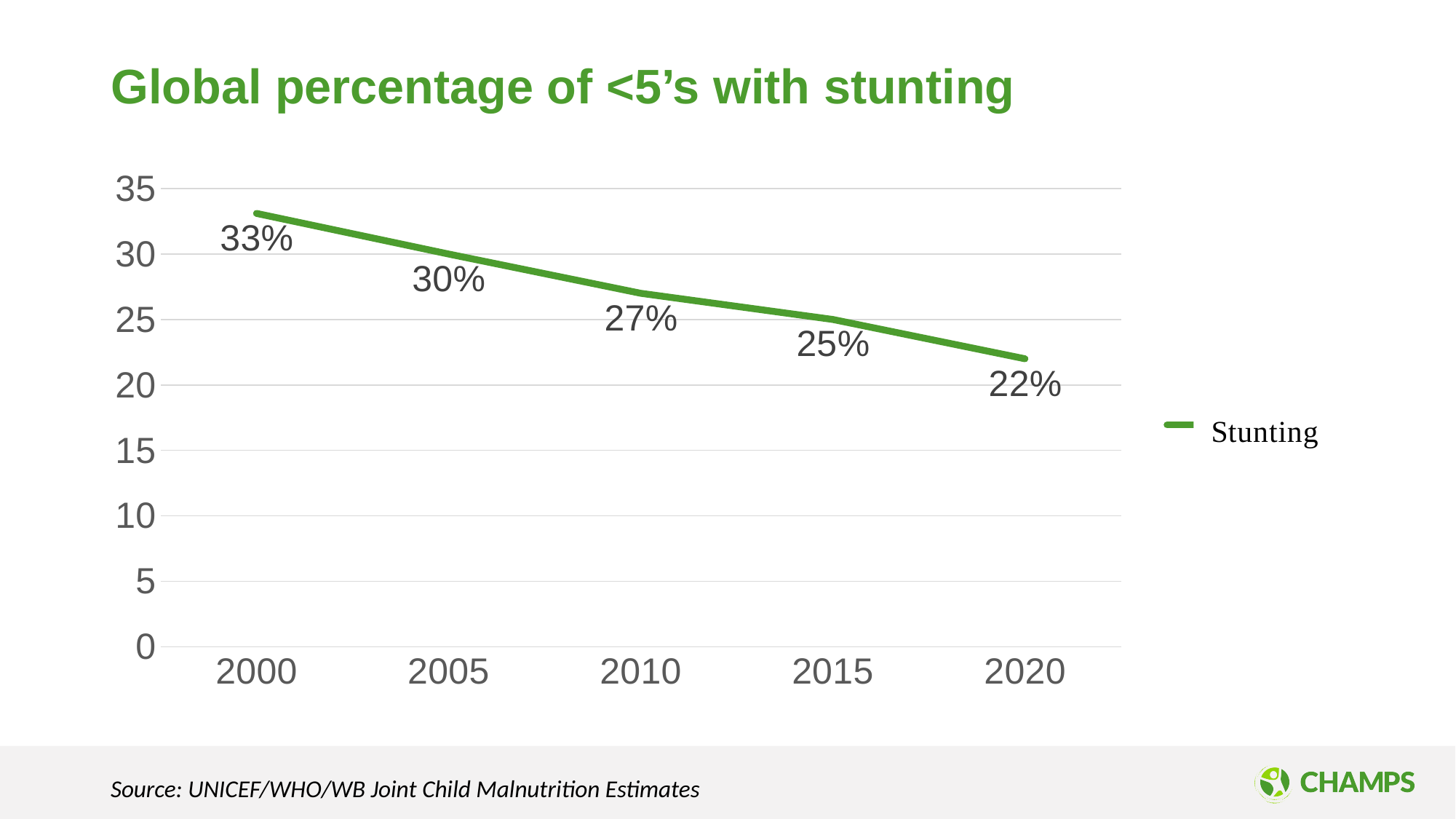
Is the value for 2015 greater or less than 30? less What is the stunting percentage for 2010? 27% How many series does the legend list? 1 What kind of chart is shown on the slide? line chart Which year has a higher stunting percentage, 2005 or 2015? 2005 What is the stunting percentage for 2020? 22% What is the stunting percentage for 2000? 33% Which year has the highest stunting percentage? 2000 What is the difference between the stunting percentage in 2000 and in 2020? 11% Does the stunting percentage rise or fall from 2000 to 2020? fall Which year has the lowest stunting percentage? 2020 How many years are plotted on the chart? 5